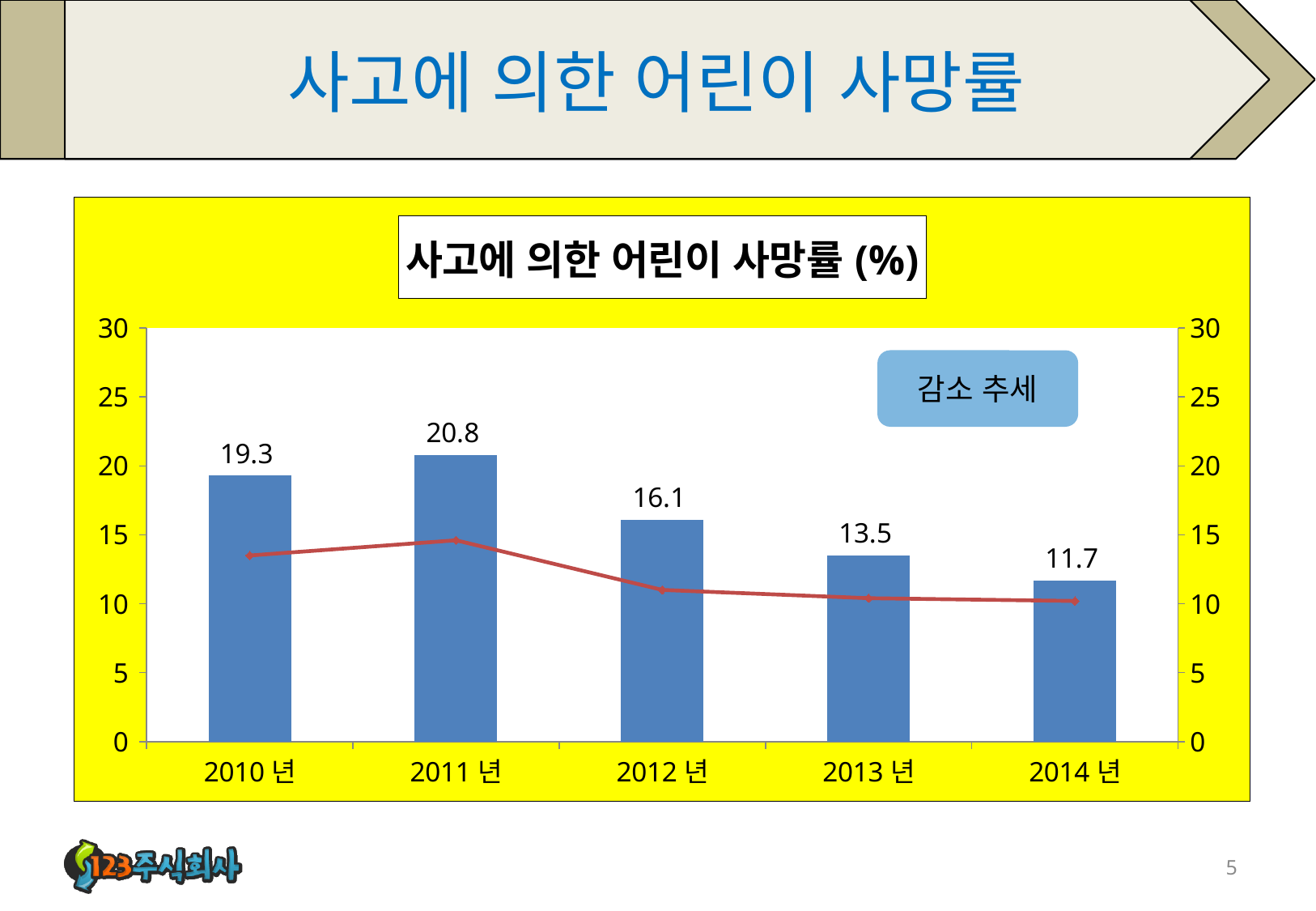
Which year has the highest bar? 2011 년 What is the difference between the values for 2011 년 and 2012 년? 4.7 What is the value shown for 2013 년? 13.5 What is the difference between the values for 2010 년 and 2014 년? 7.6 Which year has the lowest bar? 2014 년 Is the red line's value for 2010 년 greater or less than 15? less What kind of chart is this? bar chart with a line overlay How many years are shown on the x axis? 5 What is the value shown for 2010 년? 19.3 Which is larger, the value for 2010 년 or the value for 2012 년? 2010 년 Do the bar values rise or fall from 2011 년 to 2014 년? fall What is the value shown for 2014 년? 11.7